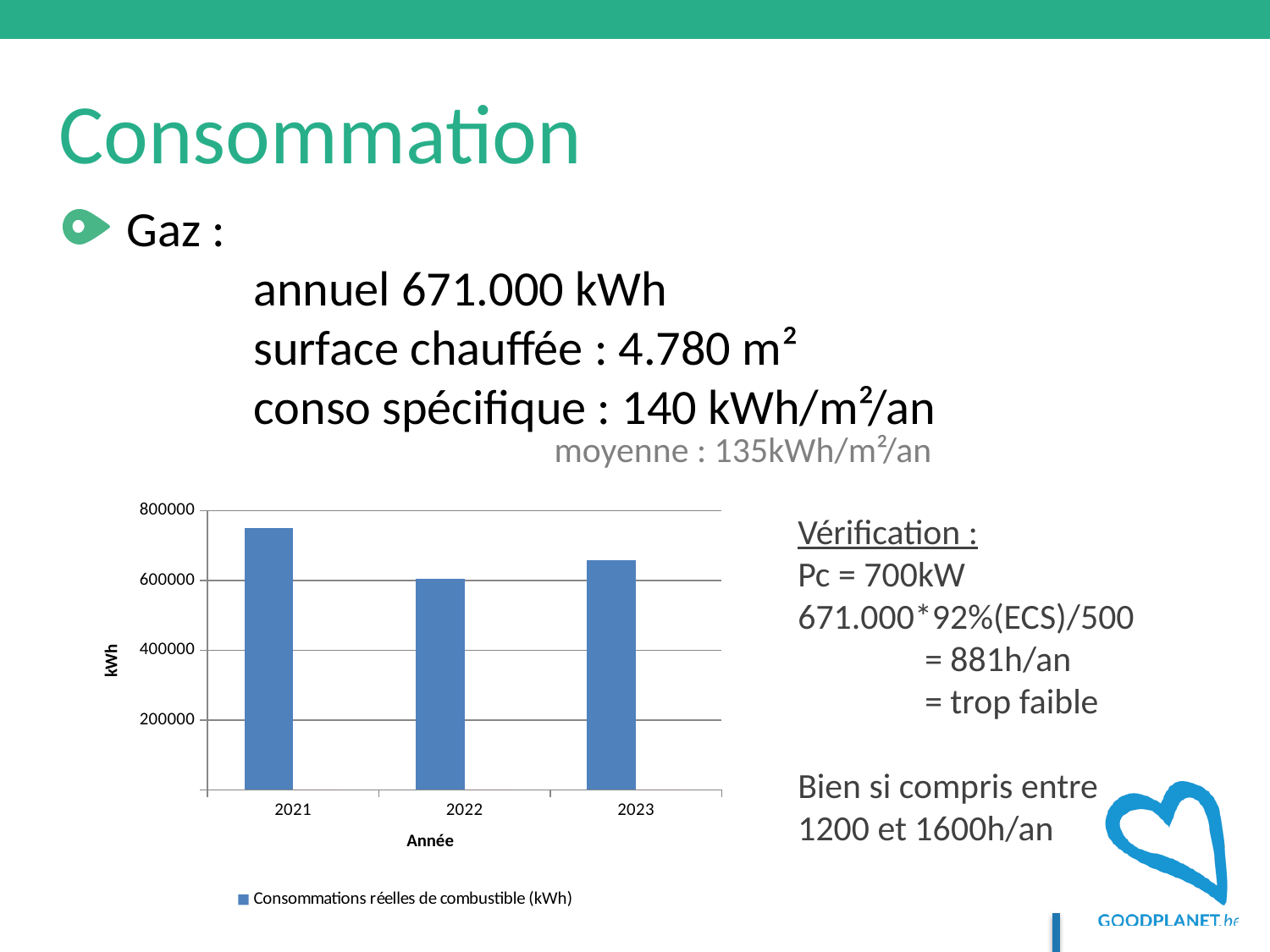
Is the value for 2021 greater or less than 800000? less What kind of chart is shown on the slide? bar chart Is the value for 2021 greater or less than 600000? greater Which year has the larger consumption, 2022 or 2023? 2023 What is the legend entry of the chart? Consommations réelles de combustible (kWh) Which year has the lowest consumption in the chart? 2022 How many series does the chart legend list? 1 How many years are shown on the x axis of the chart? 3 Which year has the highest consumption in the chart? 2021 What is the label of the x axis of the chart? Année Is the value for 2022 greater or less than 400000? greater Which year has the larger consumption, 2021 or 2023? 2021